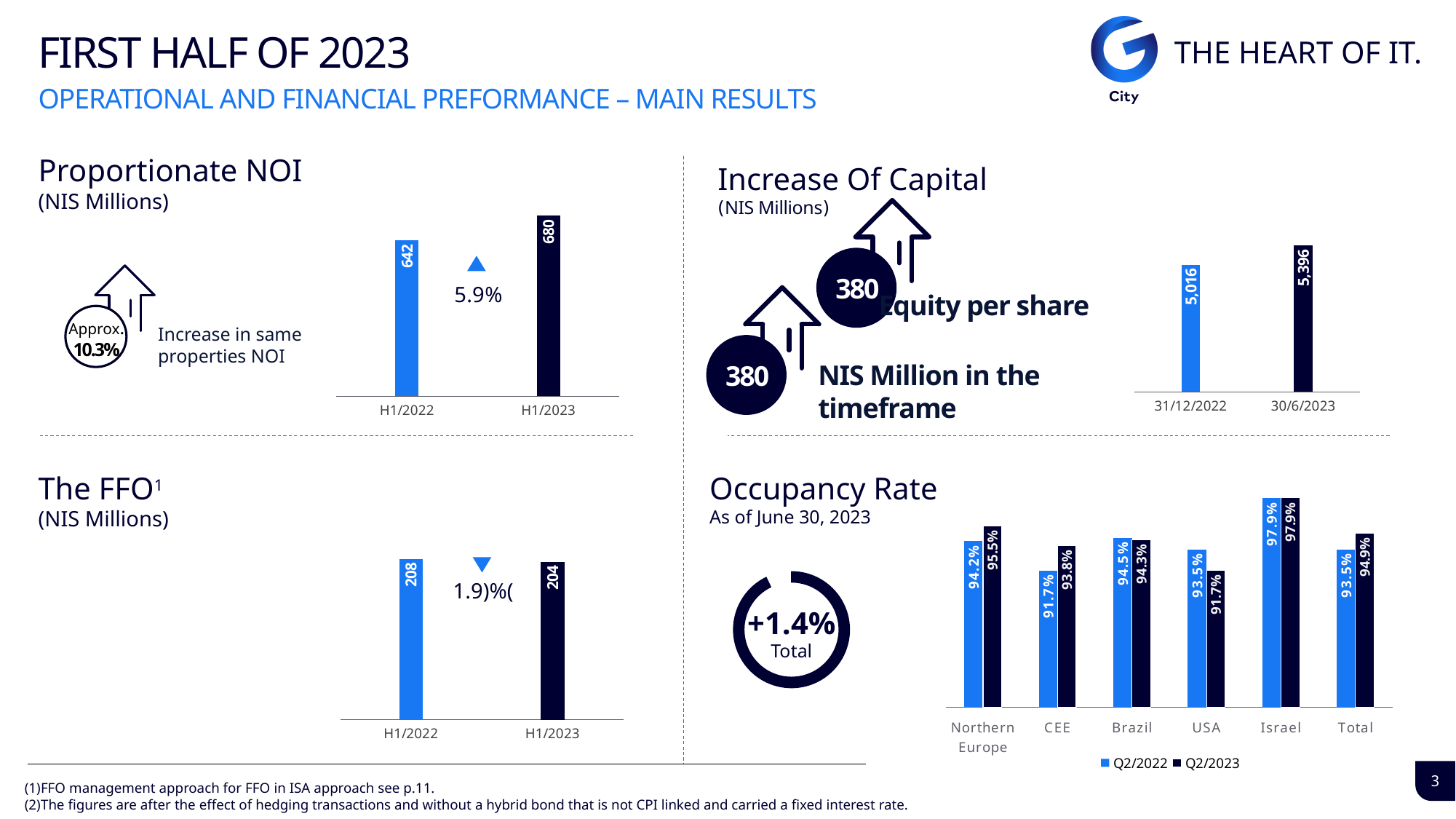
In the Occupancy Rate chart, which region has the highest Q2/2023 occupancy rate? Israel In the Occupancy Rate chart, which region has the lowest Q2/2022 occupancy rate? CEE In the Occupancy Rate chart, how many series does the legend list? 2 What kind of chart is the Occupancy Rate chart? bar chart In the Proportionate NOI chart, what is the difference between the H1/2023 and H1/2022 values? 38 In the Increase Of Capital chart, which date has the higher value, 31/12/2022 or 30/6/2023? 30/6/2023 In the Occupancy Rate chart, how many categories are shown on the x axis? 6 In the Proportionate NOI chart, what is the value for H1/2023? 680 In The FFO chart, do the values rise or fall from H1/2022 to H1/2023? fall In the Occupancy Rate chart, what is the Q2/2023 value for CEE? 93.8% In The FFO chart, what is the value for H1/2022? 208 In the Increase Of Capital chart, what is the value for 31/12/2022? 5,016